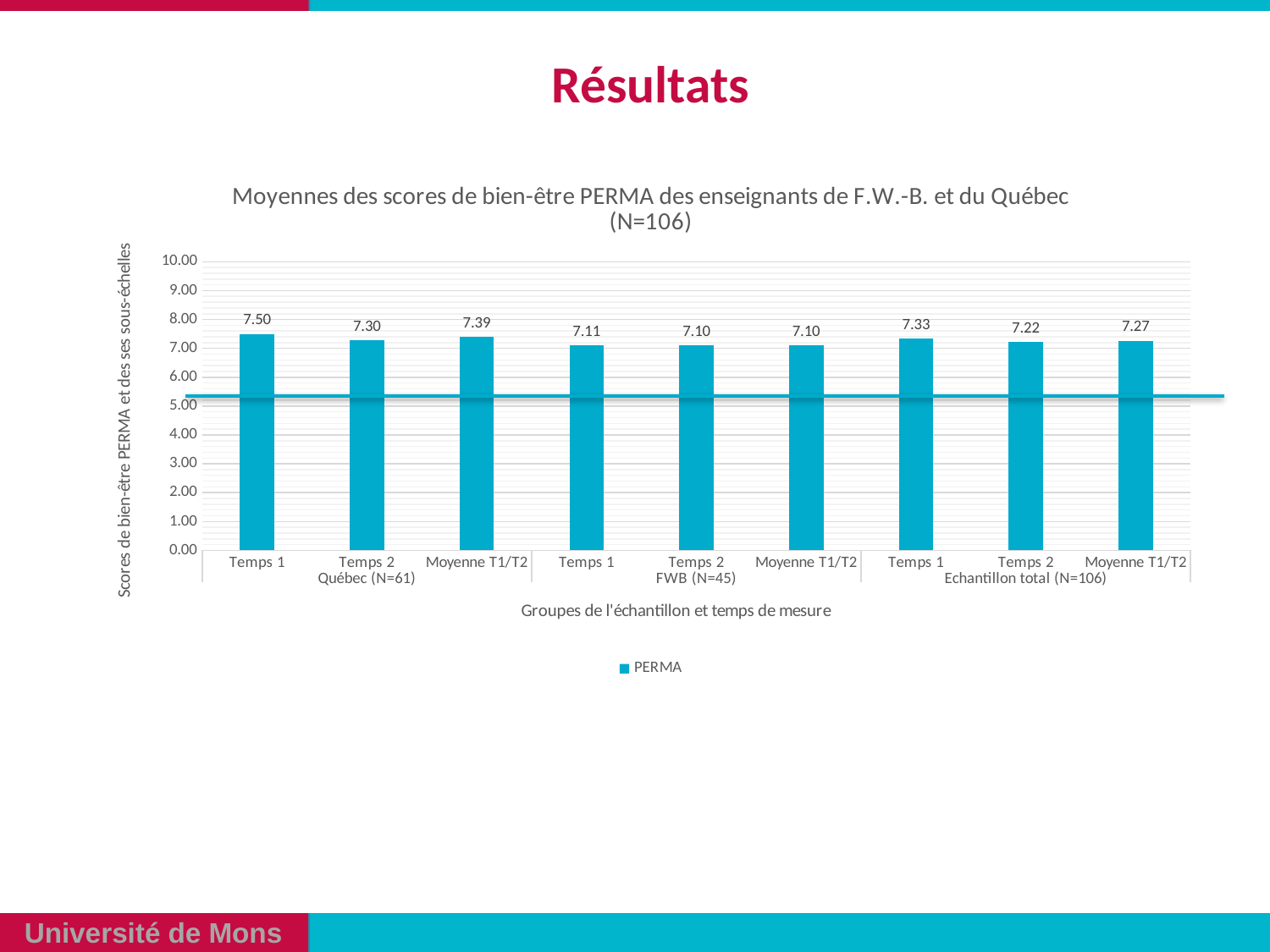
How many series does the legend list? 1 Which bar has the highest PERMA score? Temps 1, Québec (N=61) How many bars are plotted in the chart? 9 Does the PERMA score rise or fall from Temps 1 to Temps 2 in the Echantillon total (N=106) group? fall Is the PERMA score for Temps 1 in the FWB (N=45) group greater or less than 8.00? less What kind of chart is shown on the slide? bar chart What is the label of the y axis of the chart? Scores de bien-être PERMA et des ses sous-échelles What is the PERMA score for Temps 1 in the Québec (N=61) group? 7.50 What is the difference between the Temps 1 and Temps 2 PERMA scores in the Québec (N=61) group? 0.20 Which is larger: the Moyenne T1/T2 score for Québec (N=61) or for FWB (N=45)? Québec (N=61) What is the PERMA score for Temps 2 in the FWB (N=45) group? 7.10 What is the Moyenne T1/T2 PERMA score for the Echantillon total (N=106) group? 7.27